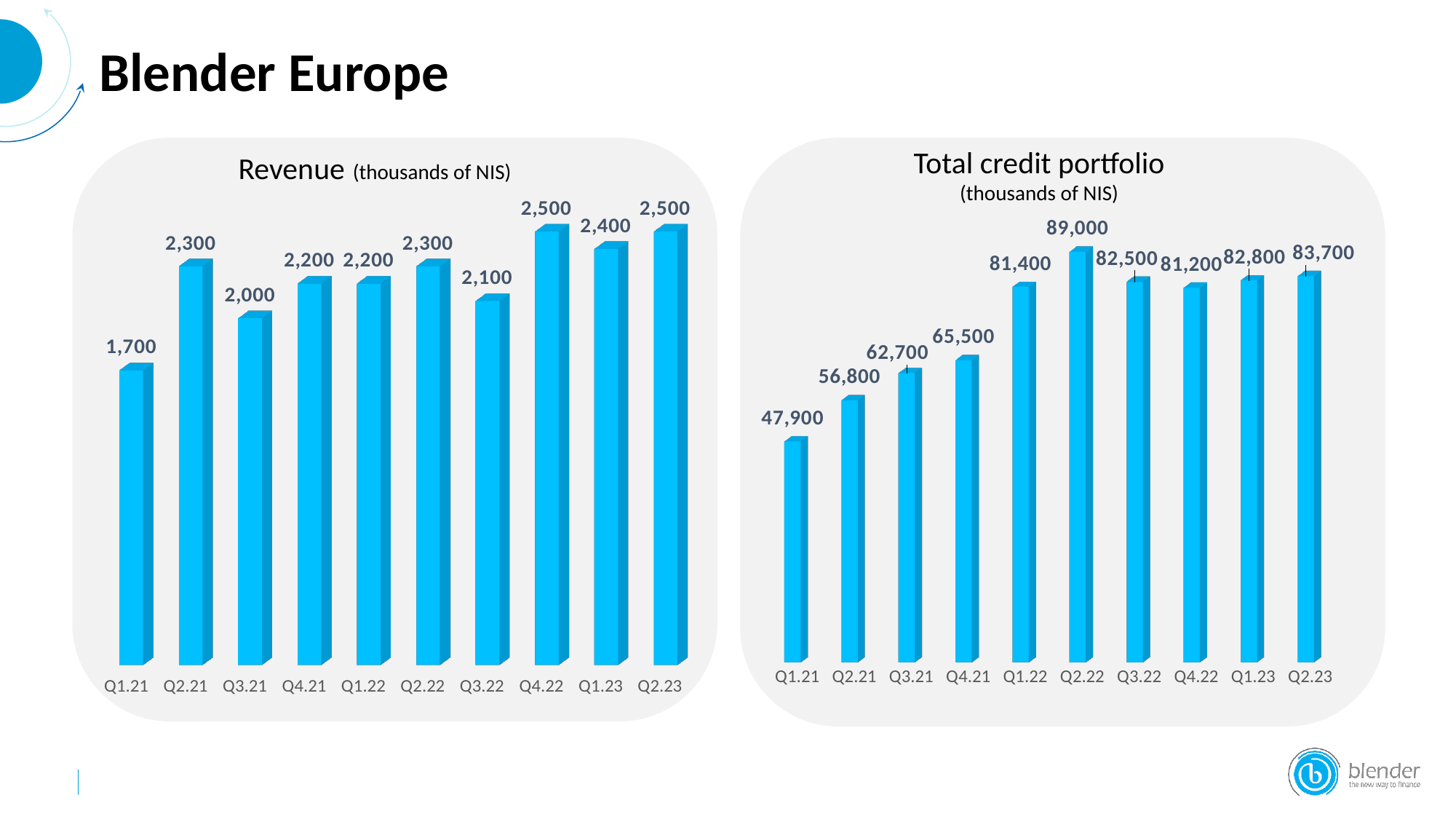
In the Revenue chart, which quarter has the lowest value? Q1.21 In the Revenue chart, what is the difference between the values for Q4.22 and Q1.21? 800 In the Total credit portfolio chart, what is the value for Q2.22? 89,000 In the Total credit portfolio chart, what is the value for Q2.23? 83,700 How many quarters are shown in the Revenue chart? 10 In the Total credit portfolio chart, which is larger, the value for Q3.22 or the value for Q4.22? Q3.22 In the Total credit portfolio chart, which quarter has the highest value? Q2.22 In the Total credit portfolio chart, which quarter has the lowest value? Q1.21 In the Revenue chart, what is the value for Q1.21? 1,700 In the Revenue chart, what is the value for Q3.22? 2,100 What kind of chart is the Total credit portfolio chart? Bar chart In the Total credit portfolio chart, what is the difference between the values for Q2.22 and Q1.21? 41,100